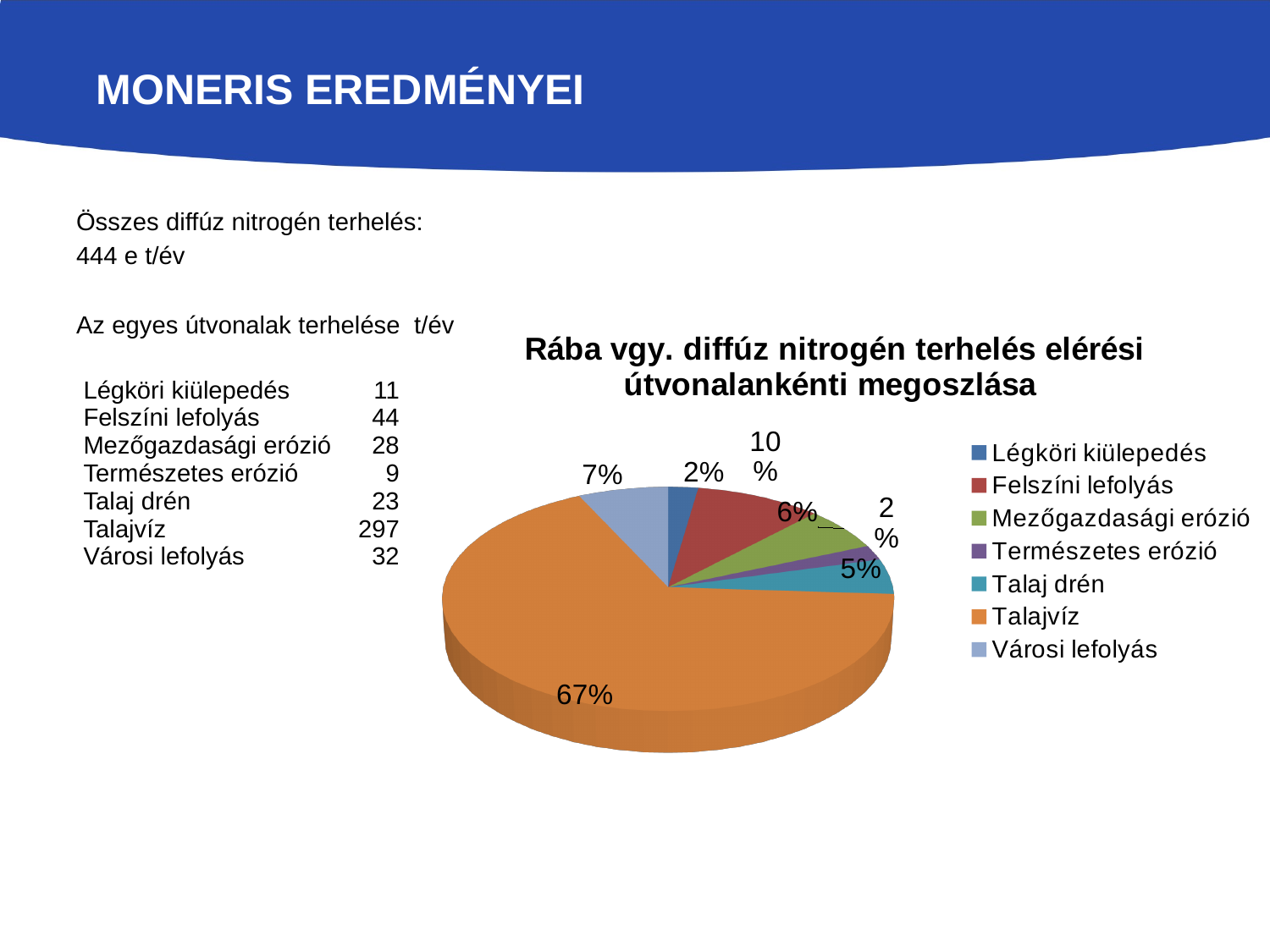
What percentage is shown for Talaj drén? 5% What share of the pie does Talajvíz represent? 67% What type of chart is shown on the slide? pie chart What is the title of the chart? Rába vgy. diffúz nitrogén terhelés elérési útvonalankénti megoszlása Which is larger, the share for Felszíni lefolyás or the share for Városi lefolyás? Felszíni lefolyás What percentage is shown for Városi lefolyás? 7% What percentage is shown for Felszíni lefolyás? 10% How many categories does the pie chart have? 7 What percentage is shown for Mezőgazdasági erózió? 6% What is the difference in percentage points between Talajvíz and Felszíni lefolyás? 57 What colour is the Talajvíz slice in the pie chart? orange Which category has the largest share of the pie? Talajvíz